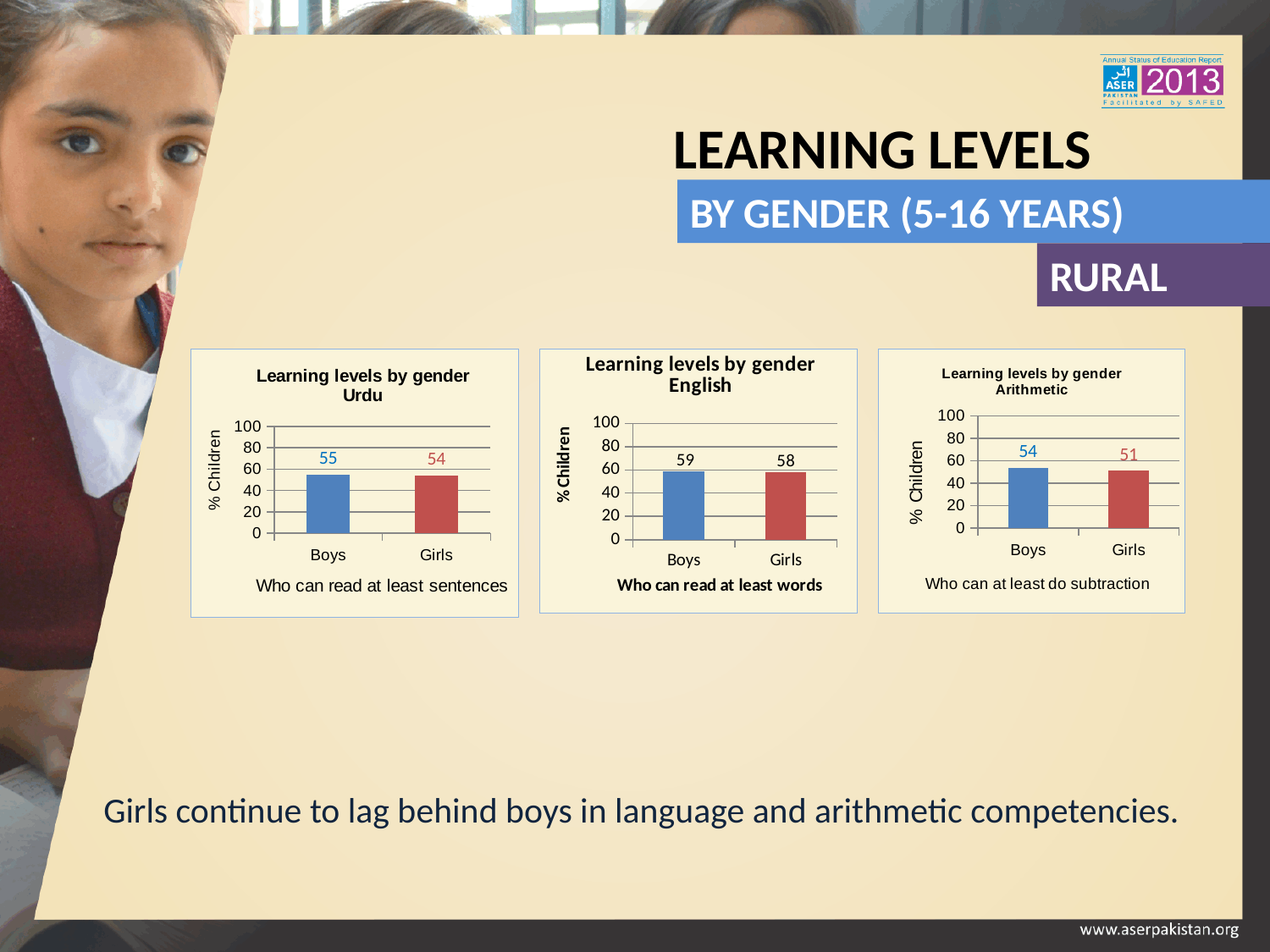
What type of chart is the 'Learning levels by gender Arithmetic' chart? bar chart How many categories are shown in the 'Learning levels by gender English' chart? 2 In the 'Learning levels by gender Urdu' chart, what is the value for Girls? 54 In the 'Learning levels by gender English' chart, what is the value for Boys? 59 In the 'Learning levels by gender Arithmetic' chart, what is the value for Girls? 51 In the 'Learning levels by gender English' chart, what is the value for Girls? 58 In the 'Learning levels by gender Urdu' chart, what is the value for Boys? 55 In the 'Learning levels by gender English' chart, what is the difference between the Boys and Girls values? 1 In the 'Learning levels by gender Arithmetic' chart, which category has the higher value, Boys or Girls? Boys In the 'Learning levels by gender Urdu' chart, is the value for Boys greater or less than 60? less In the 'Learning levels by gender Arithmetic' chart, what is the difference between the Boys and Girls values? 3 What is the y-axis label of the 'Learning levels by gender Urdu' chart? % Children